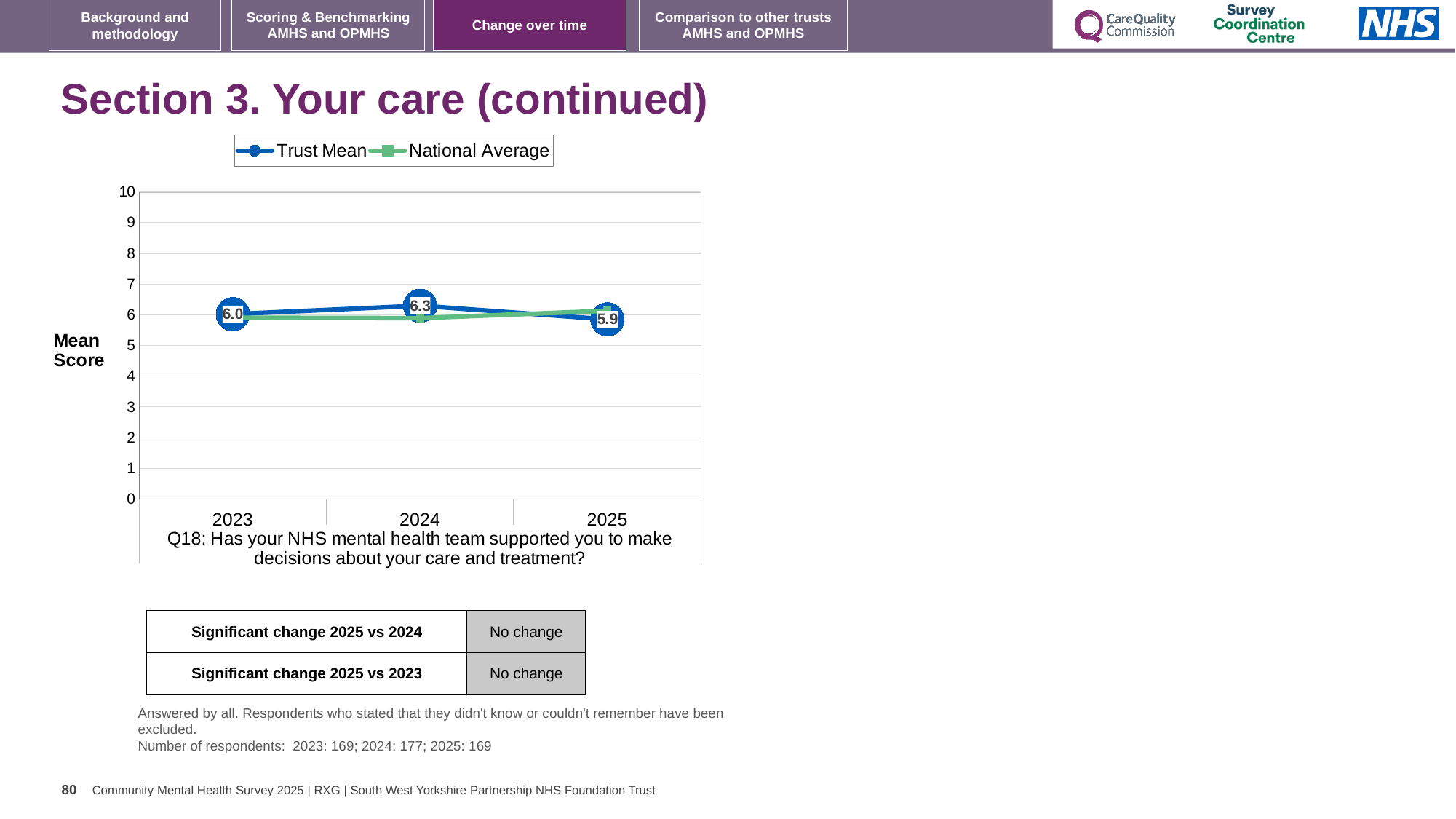
What is the Trust Mean score for 2024? 6.3 What is the difference between the Trust Mean in 2024 and in 2023? 0.3 What is the Trust Mean score for 2023? 6.0 What is the difference between the Trust Mean in 2024 and in 2025? 0.4 How many years are plotted on the x axis? 3 Which is larger, the Trust Mean in 2024 or in 2025? 2024 In which year is the Trust Mean highest? 2024 How many series does the legend list? 2 Is the National Average value for 2025 greater or less than 5? greater What kind of chart is shown on the slide? Line chart In which year is the Trust Mean lowest? 2025 What is the Trust Mean score for 2025? 5.9